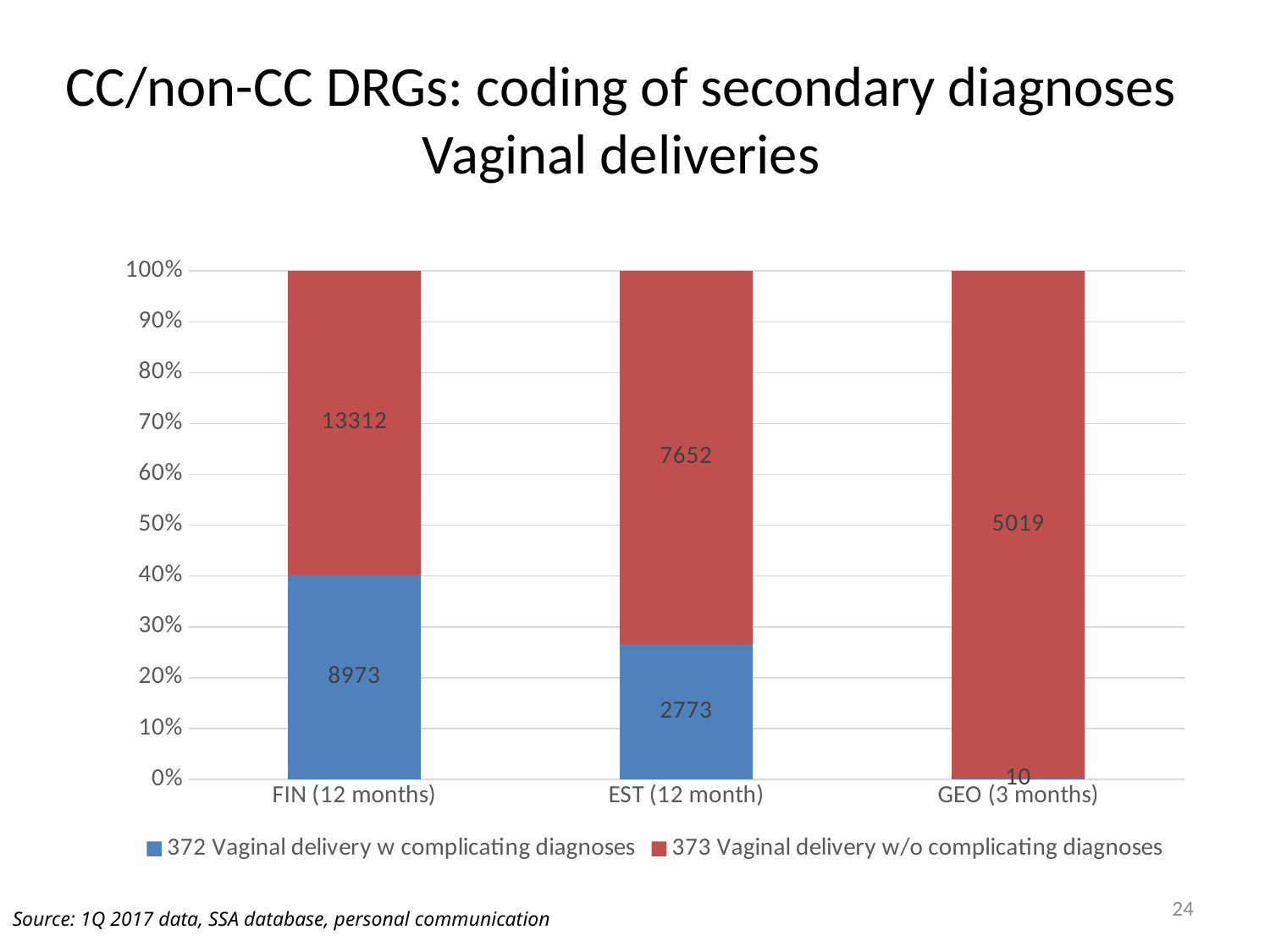
Which category has the highest value for 373 Vaginal delivery w/o complicating diagnoses? FIN (12 months) What is the difference between the 373 Vaginal delivery w/o complicating diagnoses values for FIN (12 months) and EST (12 month)? 5660 How many series does the legend list? 2 What is the total of the two values in the EST (12 month) bar? 10425 What is the value for 372 Vaginal delivery w complicating diagnoses for GEO (3 months)? 10 Which is larger: the 372 Vaginal delivery w complicating diagnoses value for FIN (12 months) or for EST (12 month)? FIN (12 months) How many categories are shown on the x axis? 3 What is the value for 372 Vaginal delivery w complicating diagnoses for FIN (12 months)? 8973 What kind of chart is shown on the slide? stacked bar chart Which category has the lowest value for 372 Vaginal delivery w complicating diagnoses? GEO (3 months) What is the value for 373 Vaginal delivery w/o complicating diagnoses for EST (12 month)? 7652 Is the share of the bar for 372 Vaginal delivery w complicating diagnoses in FIN (12 months) greater or less than 50%? less